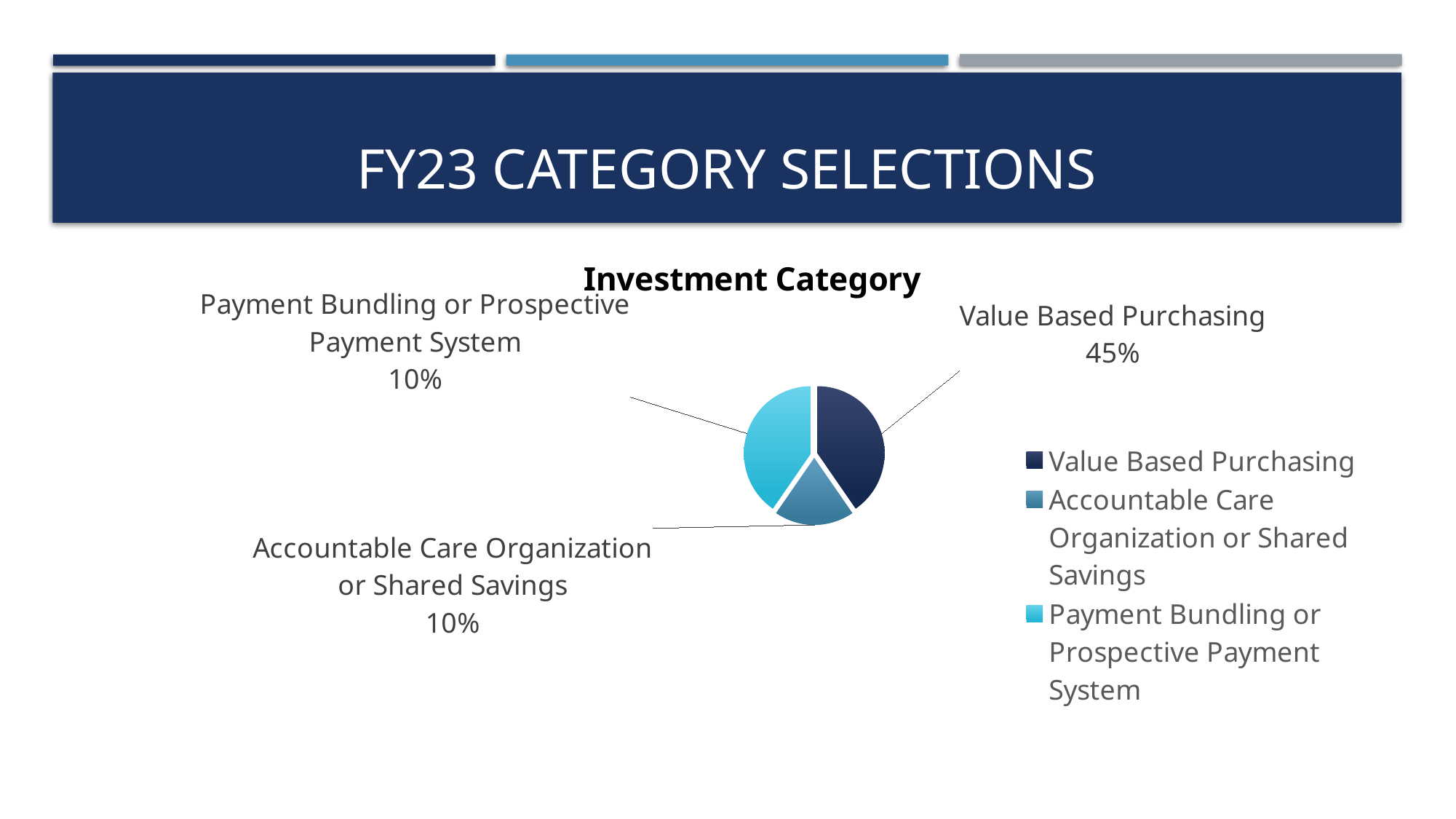
What is the title of the chart? Investment Category How many categories are shown in the pie chart? 3 What percentage is shown for Accountable Care Organization or Shared Savings? 10% What percentage is shown for Payment Bundling or Prospective Payment System? 10% How many entries does the legend list? 3 Which legend entry is shown in the darkest blue colour? Value Based Purchasing What is the difference in percentage points between Value Based Purchasing and Payment Bundling or Prospective Payment System? 35 percentage points What share of the pie does Value Based Purchasing represent? 45% What kind of chart is shown on the slide? Pie chart What percentage is shown for Value Based Purchasing? 45% Which is larger, the share for Value Based Purchasing or the share for Accountable Care Organization or Shared Savings? Value Based Purchasing